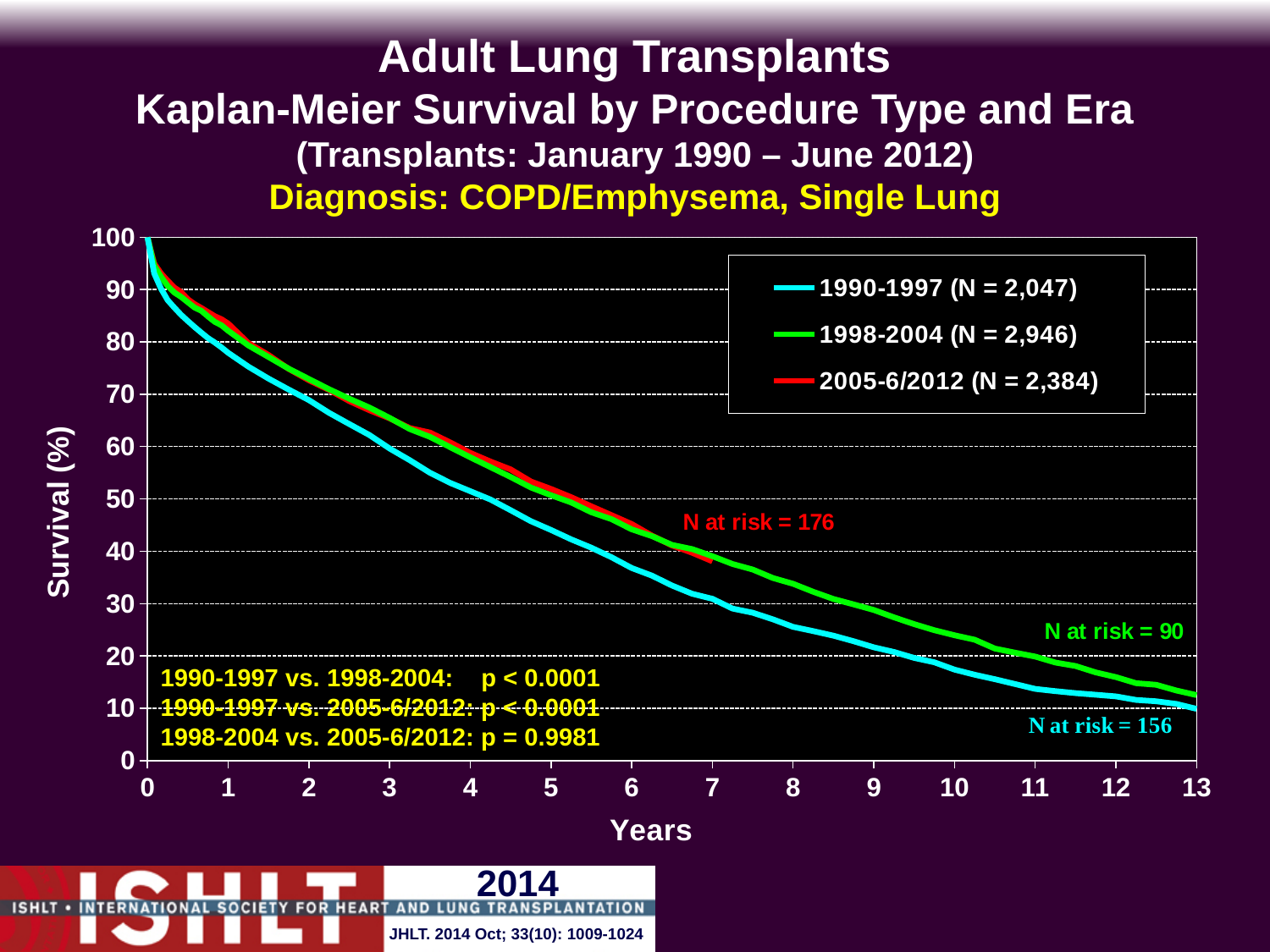
What kind of chart is shown on the slide? line chart Do the survival curves rise or fall as years increase? fall What is the N at risk annotated for the 2005-6/2012 curve? 176 What p-value is shown for 1998-2004 vs. 2005-6/2012? p = 0.9981 At 5 years, which curve shows higher survival: 1990-1997 or 1998-2004? 1998-2004 What is the difference between the N for 1998-2004 and the N for 1990-1997 in the legend? 899 What is the N for the 1990-1997 era shown in the legend? 2,047 Which era has the largest N in the legend? 1998-2004 What is the N for the 1998-2004 era shown in the legend? 2,946 Is the survival value for the 1990-1997 curve at 8 years greater or less than 30? less What is the N at risk annotated for the 1998-2004 curve? 90 How many series does the legend list? 3